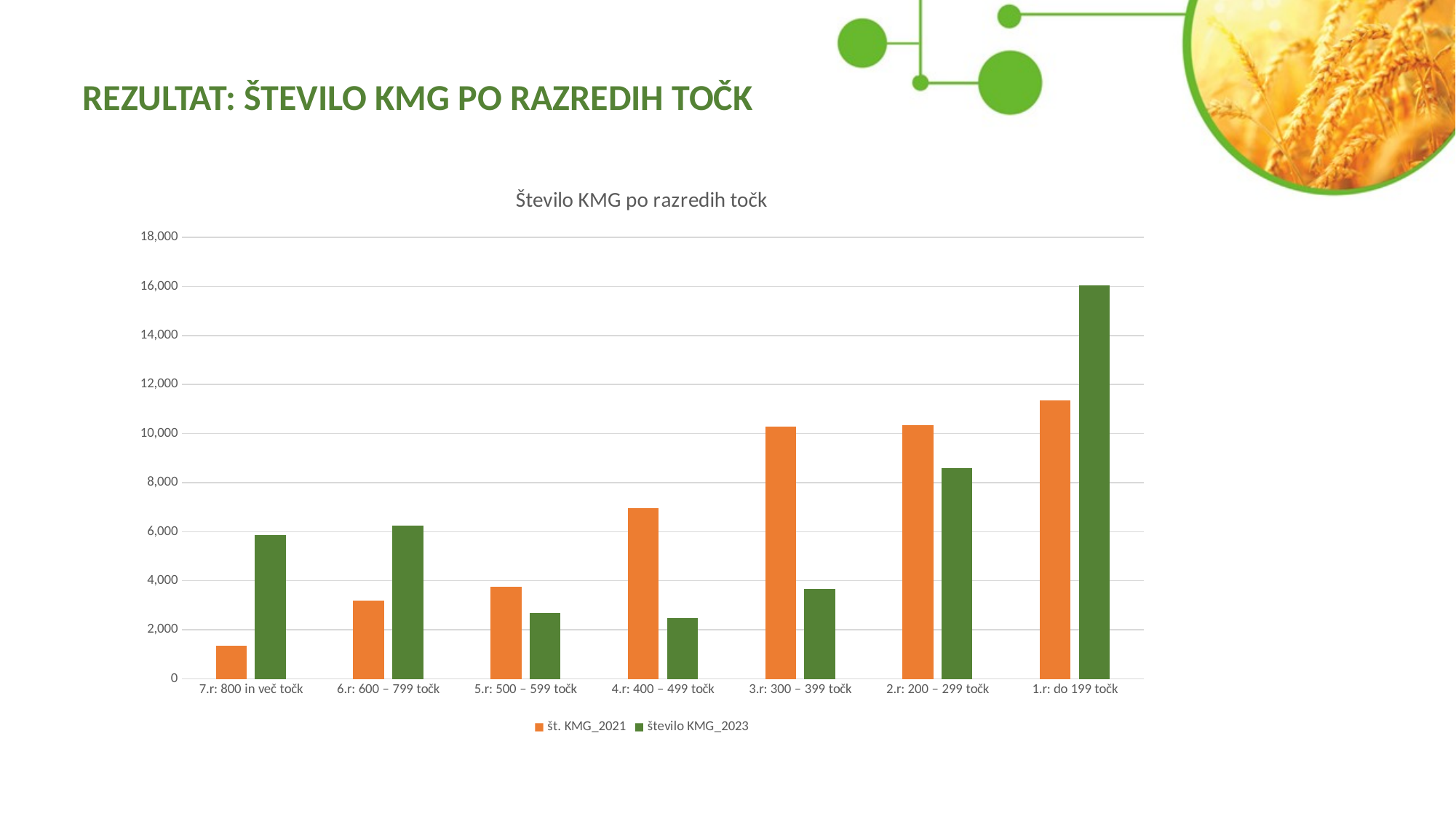
Is the value for št. KMG_2021 in category 7.r: 800 in več točk greater or less than 2,000? less Which category has the highest value for št. KMG_2021? 1.r: do 199 točk Is the value for št. KMG_2021 in category 4.r: 400 – 499 točk greater or less than 6,000? greater In category 7.r: 800 in več točk, which series has the larger value, št. KMG_2021 or število KMG_2023? število KMG_2023 What kind of chart is shown on the slide? bar chart Do the values for št. KMG_2021 rise or fall from left to right along the x axis? rise How many series does the legend list? 2 Is the value for število KMG_2023 in category 1.r: do 199 točk greater or less than 14,000? greater Which category has the highest value for število KMG_2023? 1.r: do 199 točk Which category has the lowest value for št. KMG_2021? 7.r: 800 in več točk How many point-class categories are shown on the x axis? 7 In category 4.r: 400 – 499 točk, which series has the larger value, št. KMG_2021 or število KMG_2023? št. KMG_2021